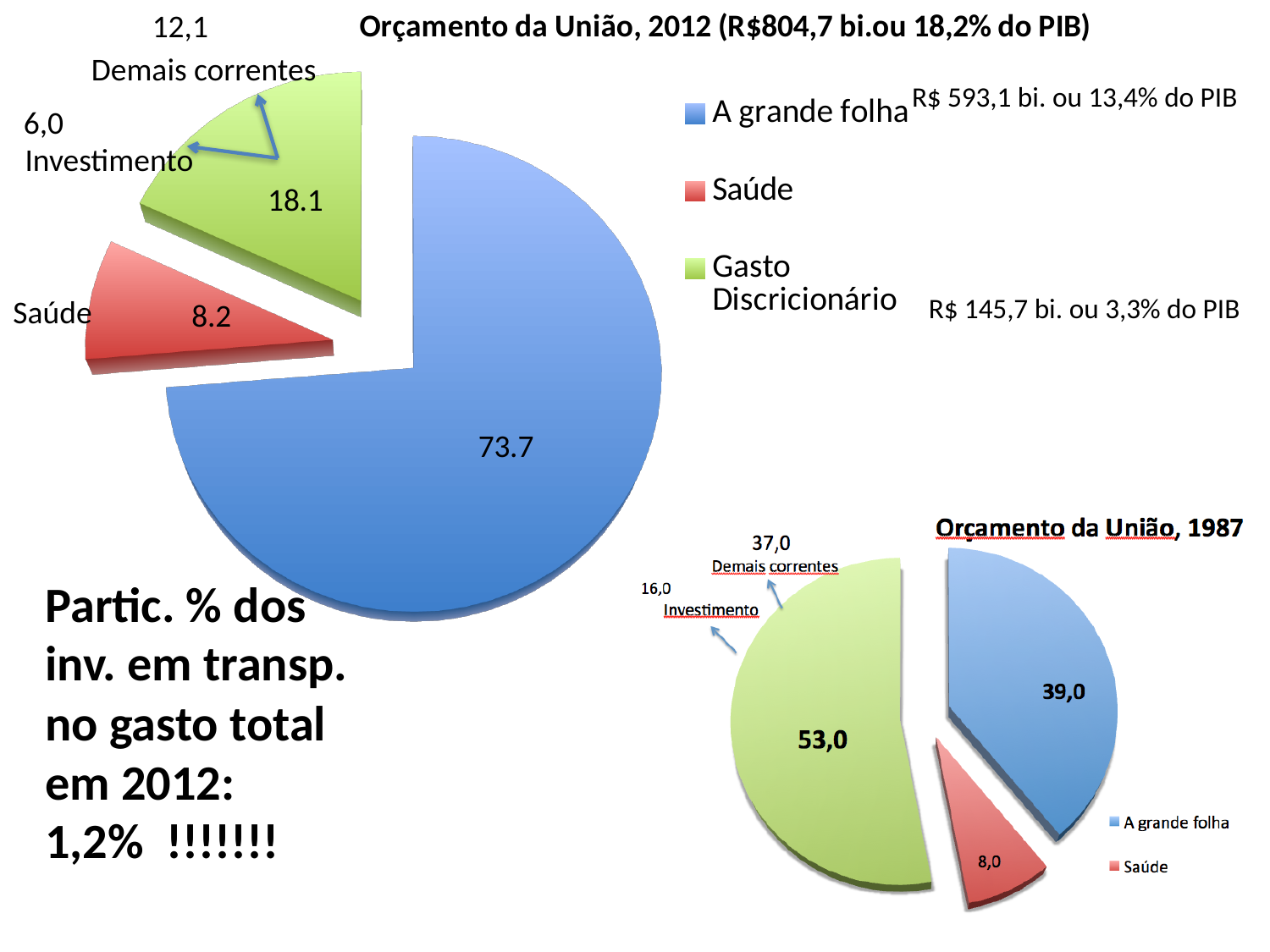
In the 'Orçamento da União, 1987' chart, which is larger: the value for A grande folha or the value for Saúde? A grande folha In the 'Orçamento da União, 1987' chart, what is the value shown for Saúde? 8,0 In the 'Orçamento da União, 2012' chart, what is the value shown for Gasto Discricionário? 18.1 In the 'Orçamento da União, 2012' chart, what is the value shown for Saúde? 8.2 In the 'Orçamento da União, 1987' chart, what is the value shown on the green slice? 53,0 How many entries does the legend of the 'Orçamento da União, 2012' chart list? 3 In the 'Orçamento da União, 2012' chart, which category has the largest slice? A grande folha In the 'Orçamento da União, 2012' chart, what is the value shown for A grande folha? 73.7 In the 'Orçamento da União, 1987' chart, what is the value shown for A grande folha? 39,0 In the 'Orçamento da União, 2012' chart, which category has the smallest slice? Saúde What type of chart is 'Orçamento da União, 2012'? Pie chart In the 'Orçamento da União, 2012' chart, what is the difference between the values for A grande folha and Gasto Discricionário? 55.6